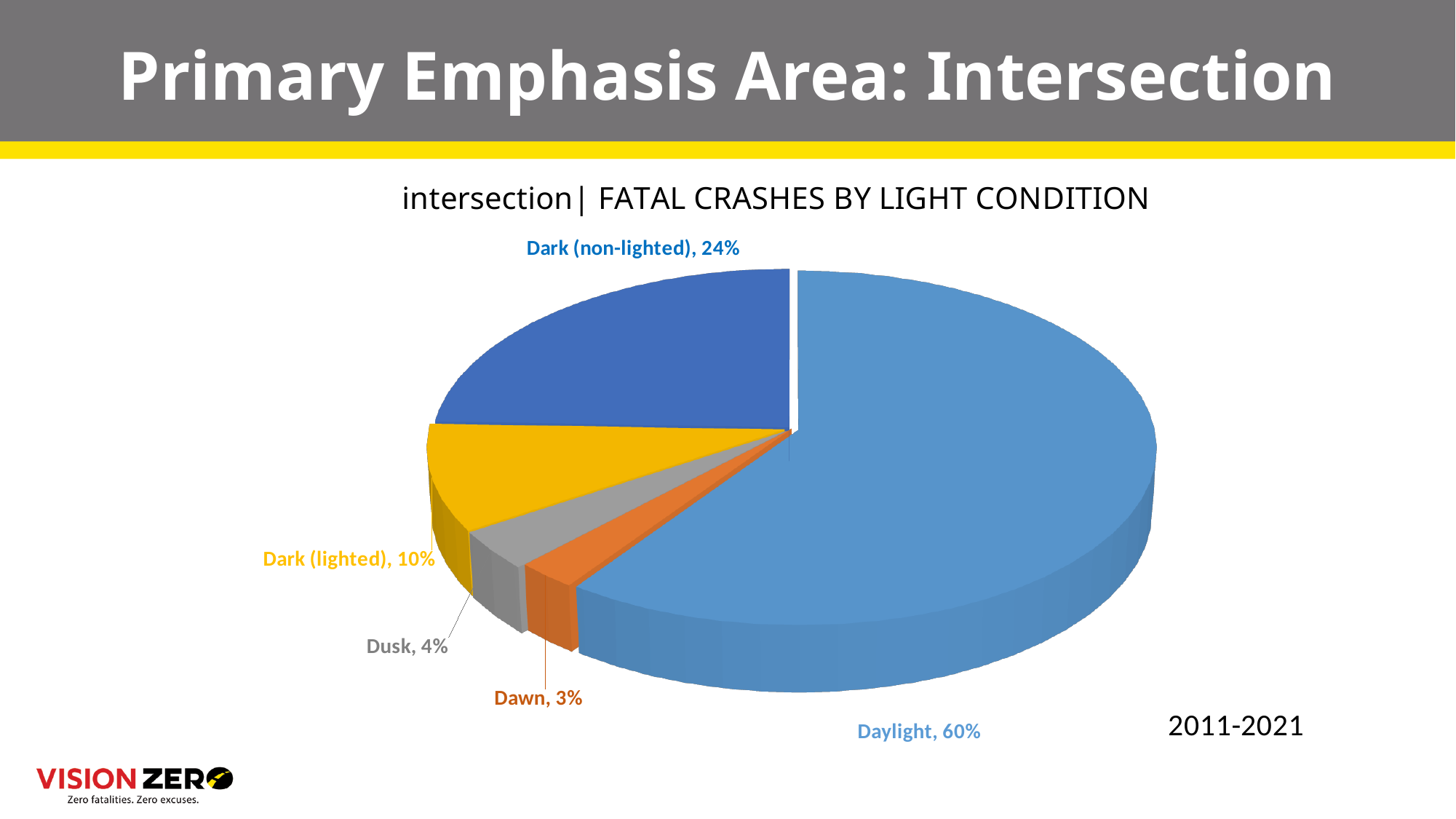
How many light condition categories are shown in the pie chart? 5 What percentage is shown for Dawn? 3% What percentage is shown for Dusk? 4% What is the title of the chart? intersection| FATAL CRASHES BY LIGHT CONDITION What is the difference in percentage points between Daylight and Dark (non-lighted)? 36 What share of intersection fatal crashes occurred in Dark (non-lighted) conditions? 24% Which is larger, the share for Dark (lighted) or the share for Dusk? Dark (lighted) What share of intersection fatal crashes occurred in Daylight? 60% What kind of chart is shown on the slide? Pie chart What percentage is shown for Dark (lighted)? 10% Which light condition has the smallest share of fatal crashes? Dawn Which light condition has the largest share of fatal crashes? Daylight